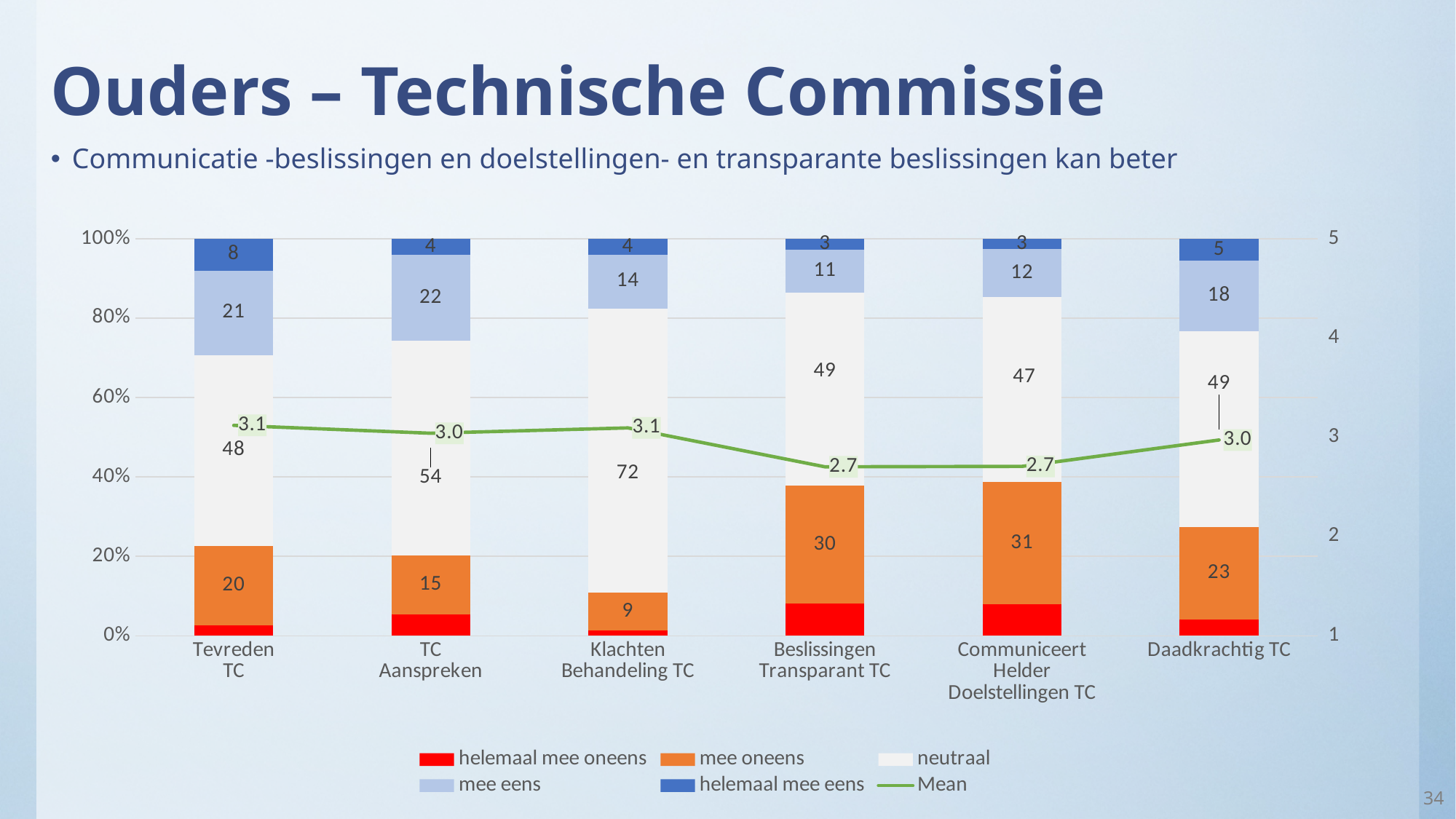
What is the difference between the 'neutraal' values for TC Aanspreken and Tevreden TC? 6 How many series does the legend list? 6 What is the difference between the 'mee eens' values for Tevreden TC and Daadkrachtig TC? 3 What is the 'helemaal mee eens' value for TC Aanspreken? 4 What is the Mean value shown for Beslissingen Transparant TC? 2.7 What is the Mean value shown for Daadkrachtig TC? 3.0 Which category has the lowest 'mee oneens' value? Klachten Behandeling TC Which has a larger 'helemaal mee eens' value, Tevreden TC or Daadkrachtig TC? Tevreden TC How many categories are shown on the x axis of the chart? 6 What kind of chart is shown on the slide? combination stacked bar and line chart What is the value of the 'neutraal' segment for Klachten Behandeling TC? 72 Which category has the highest 'mee oneens' value? Communiceert Helder Doelstellingen TC